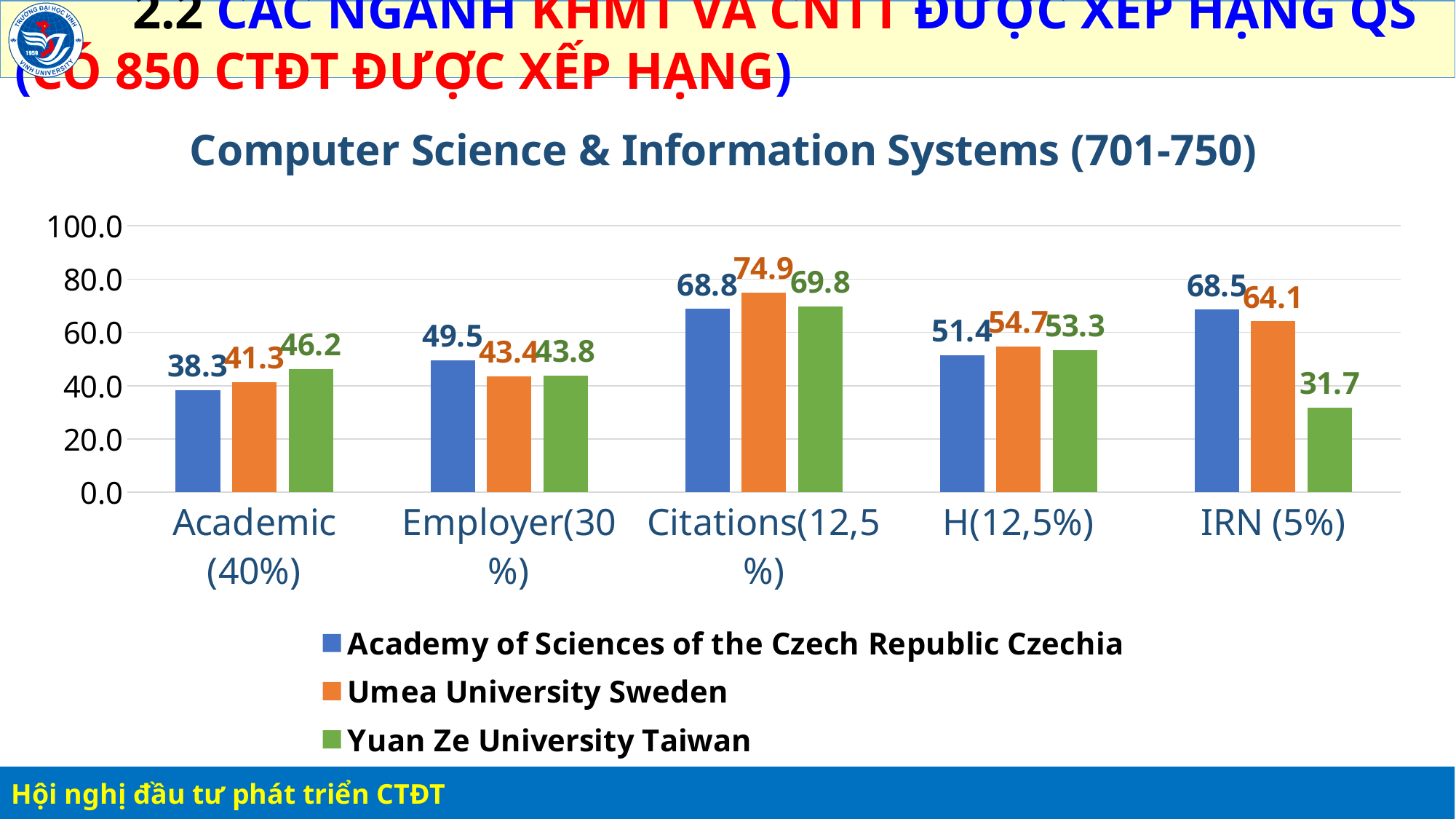
What is the value for Umea University Sweden in the Citations(12,5%) category? 74.9 What is the value for Yuan Ze University Taiwan in the IRN (5%) category? 31.7 Which category has the highest value for Academy of Sciences of the Czech Republic Czechia? Citations(12,5%) Which category has the lowest value for Yuan Ze University Taiwan? IRN (5%) What type of chart is shown on the slide? bar chart What is the title of the chart? Computer Science & Information Systems (701-750) In the Academic (40%) category, which is larger: the value for Academy of Sciences of the Czech Republic Czechia or for Yuan Ze University Taiwan? Yuan Ze University Taiwan What is the difference between the Umea University Sweden and Yuan Ze University Taiwan values in the IRN (5%) category? 32.4 How many categories are shown on the x axis? 5 How many series does the legend list? 3 What is the value for Academy of Sciences of the Czech Republic Czechia in the Employer(30%) category? 49.5 Is the value for Umea University Sweden in the H(12,5%) category greater or less than 60.0? less